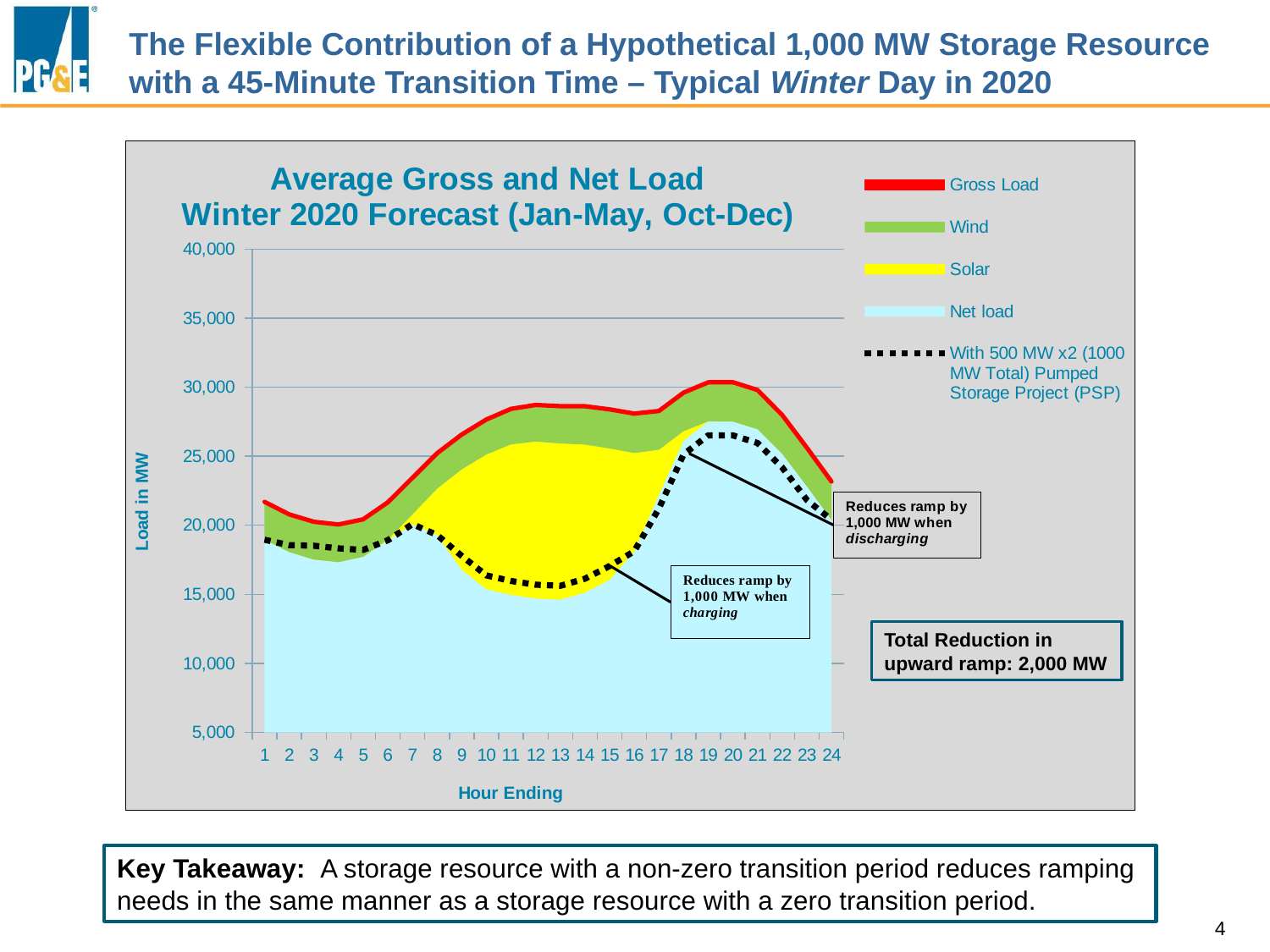
How many hours are shown along the x axis of the chart? 24 What kind of chart is shown on the slide? area chart Does the Gross Load rise or fall from hour ending 4 to hour ending 12? rises Does the Net load rise or fall from hour ending 8 to hour ending 13? falls Is the Gross Load value at hour ending 1 greater or less than 20,000? greater Which legend entry is drawn as a dotted black line? With 500 MW x2 (1000 MW Total) Pumped Storage Project (PSP) Is the Gross Load value at hour ending 4 greater or less than 25,000? less According to the annotation box on the chart, what is the total reduction in upward ramp? 2,000 MW How many series does the chart legend list? 5 Is the Net load value at hour ending 13 greater or less than 20,000? less Which is larger, the Gross Load at hour ending 12 or at hour ending 1? hour ending 12